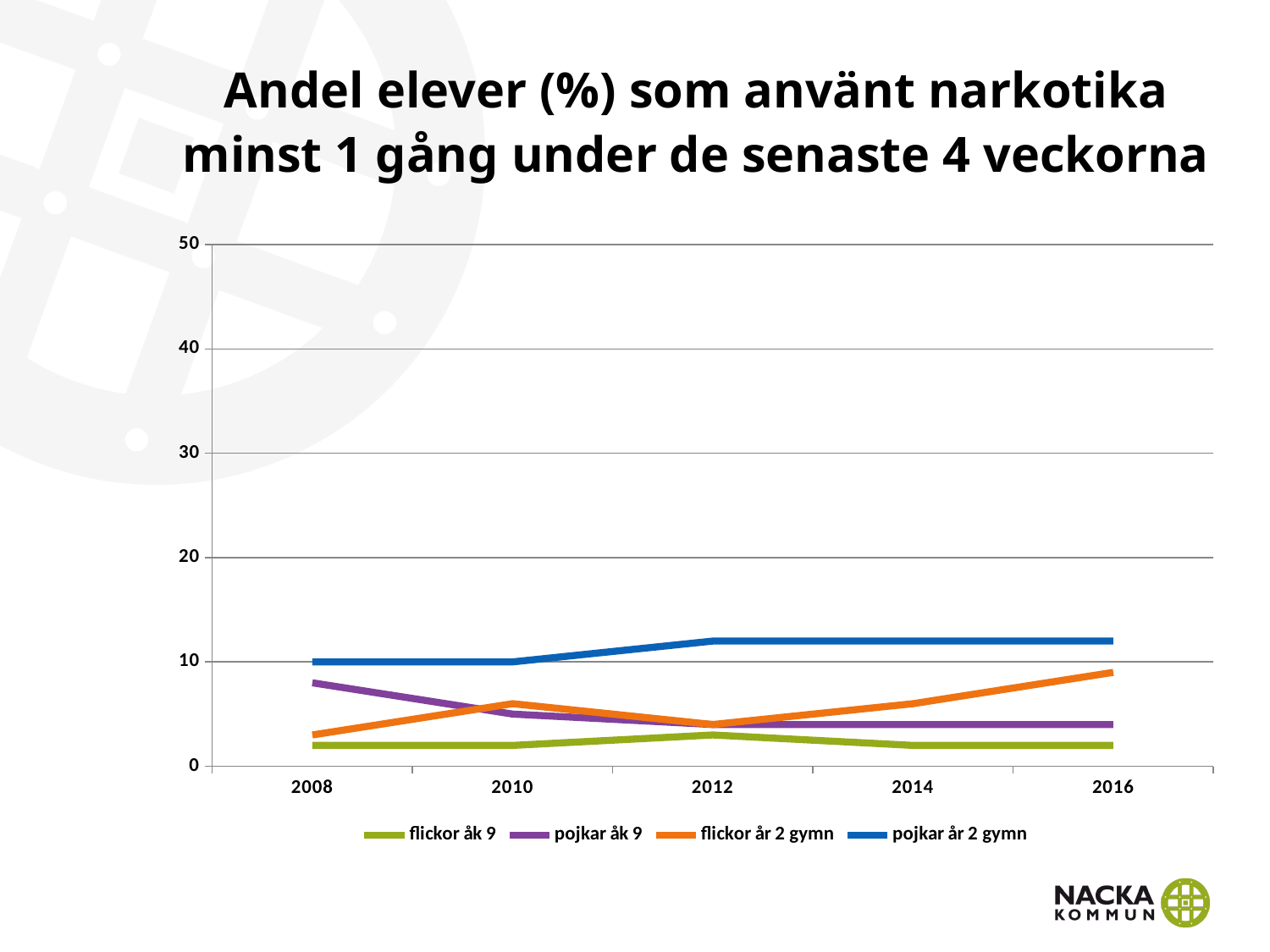
What is the value for pojkar år 2 gymn in 2010? 10 What kind of chart is shown on the slide? line chart Is the value for flickor år 2 gymn in 2012 greater or less than 10? less Which series has the lowest value in 2016? flickor åk 9 Which series has the highest value in 2016? pojkar år 2 gymn What is the value for pojkar år 2 gymn in 2008? 10 How many series does the legend list? 4 In 2008, which is higher: pojkar åk 9 or flickor åk 9? pojkar åk 9 Is the value for pojkar år 2 gymn in 2016 greater or less than 10? greater Is the value for flickor åk 9 in 2008 greater or less than 10? less Which colour is used for the flickor år 2 gymn line? orange How many years are shown on the x axis? 5